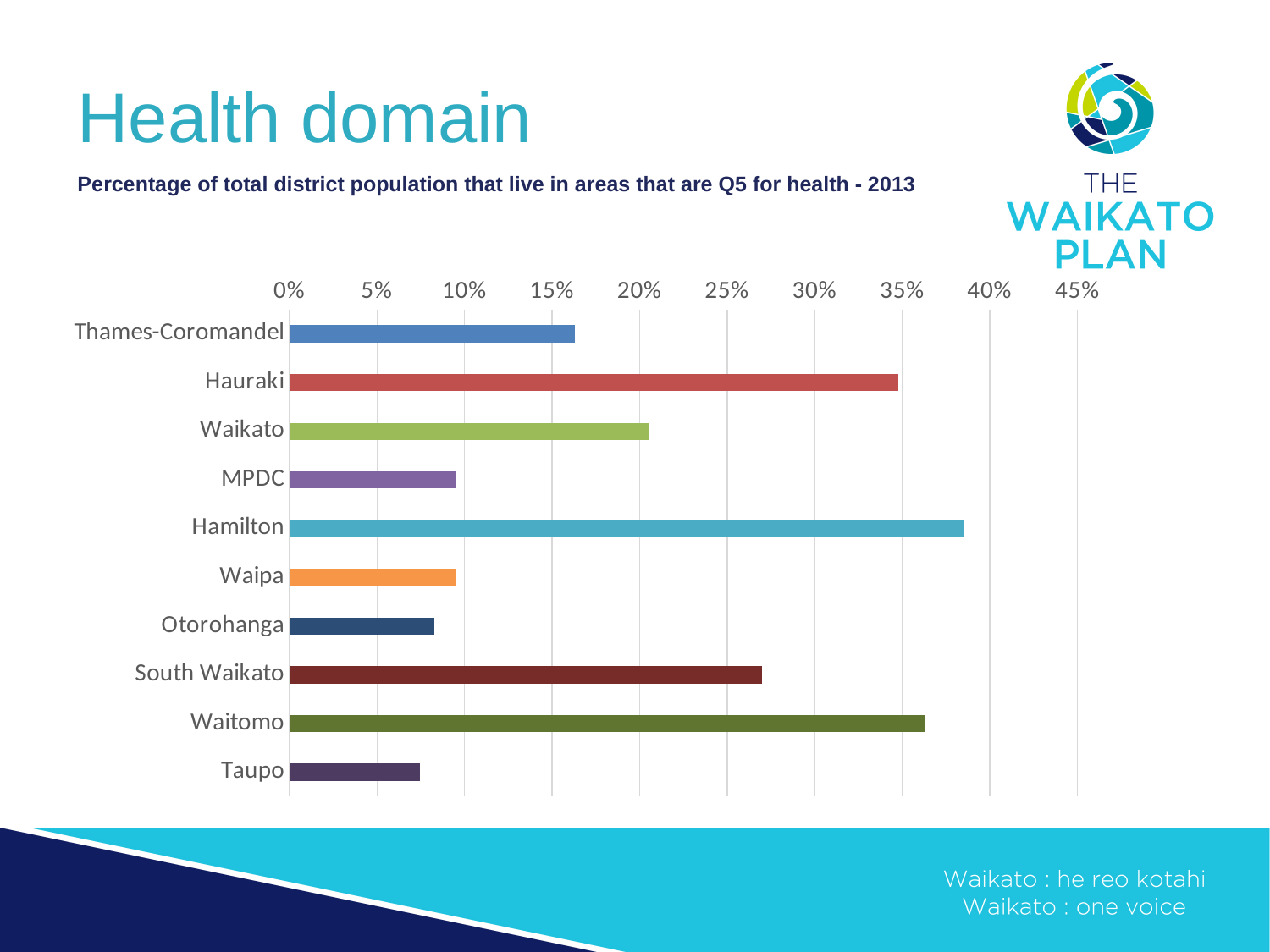
What year does the chart's data refer to, according to its title? 2013 Which has a higher value, Hauraki or Thames-Coromandel? Hauraki Which district has the highest percentage of population living in Q5 areas for health? Hamilton Is the value for South Waikato greater or less than 25%? greater Is the value for Hauraki greater or less than 30%? greater What kind of chart is shown on the slide? bar chart Is the value for Thames-Coromandel greater or less than 15%? greater Which has a higher value, South Waikato or Waikato? South Waikato How many districts are shown in the chart? 10